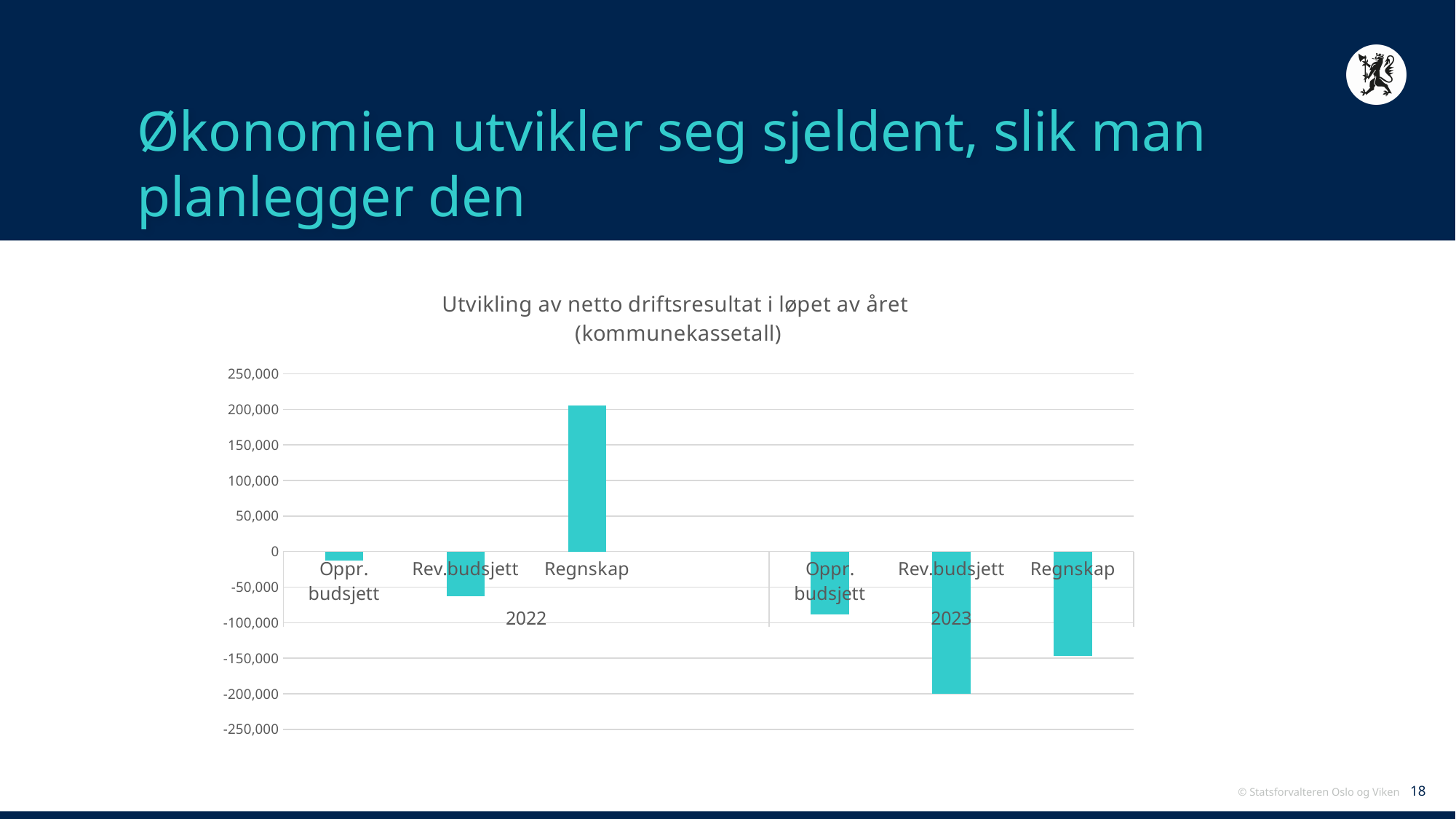
Which bar has the highest value in the chart? Regnskap 2022 Which bar has the lowest value in the chart? Rev.budsjett 2023 Is the value for Oppr. budsjett in 2023 greater or less than -50,000? less How many bars are plotted in the chart? 6 Is the value for Regnskap in 2022 greater or less than 150,000? greater Which is larger, the value for Oppr. budsjett in 2022 or Rev.budsjett in 2022? Oppr. budsjett 2022 Is the value for Rev.budsjett in 2023 greater or less than -150,000? less How many year groups does the x axis show? 2 What kind of chart is shown on the slide? bar chart What is the title of the chart? Utvikling av netto driftsresultat i løpet av året (kommunekassetall) Which is larger, the value for Regnskap in 2023 or Rev.budsjett in 2023? Regnskap 2023